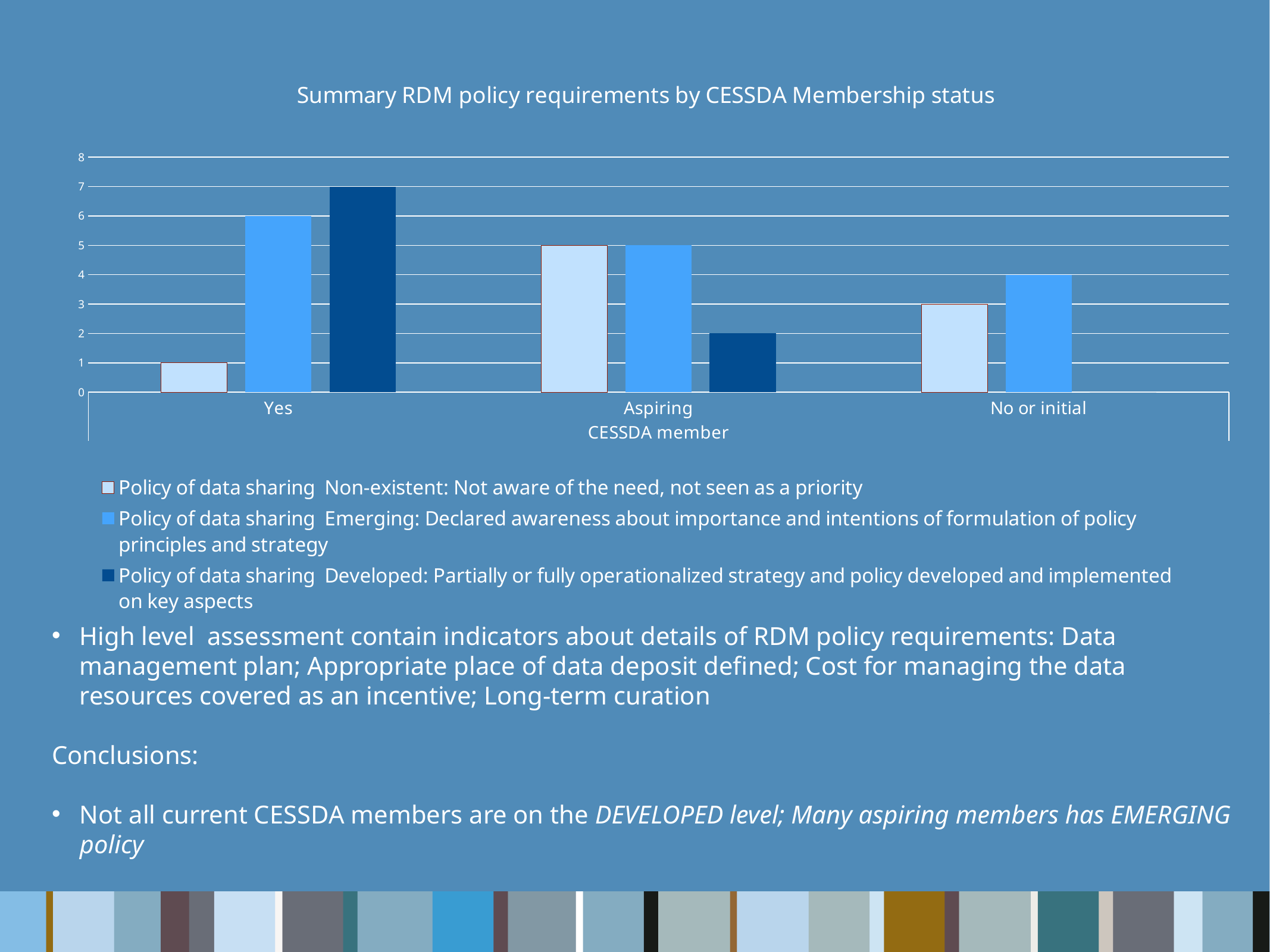
What is the title of the chart? Summary RDM policy requirements by CESSDA Membership status Which category has the highest value for the 'Developed' series? Yes What kind of chart is shown on the slide? bar chart Which category has the lowest value for the 'Non-existent' series? Yes How many series does the chart legend list? 3 What is the difference between the 'Developed' values for 'Yes' and 'Aspiring'? 5 How many categories are shown on the x axis of the chart? 3 What is the value of the 'Non-existent' series for the 'Aspiring' category? 5 Which is larger: the 'Non-existent' value for 'No or initial' or the 'Non-existent' value for 'Yes'? No or initial What is the value of the 'Emerging' series for the 'No or initial' category? 4 What is the value of the 'Developed' series for the 'Yes' category? 7 What is the value of the 'Emerging' series for the 'Yes' category? 6